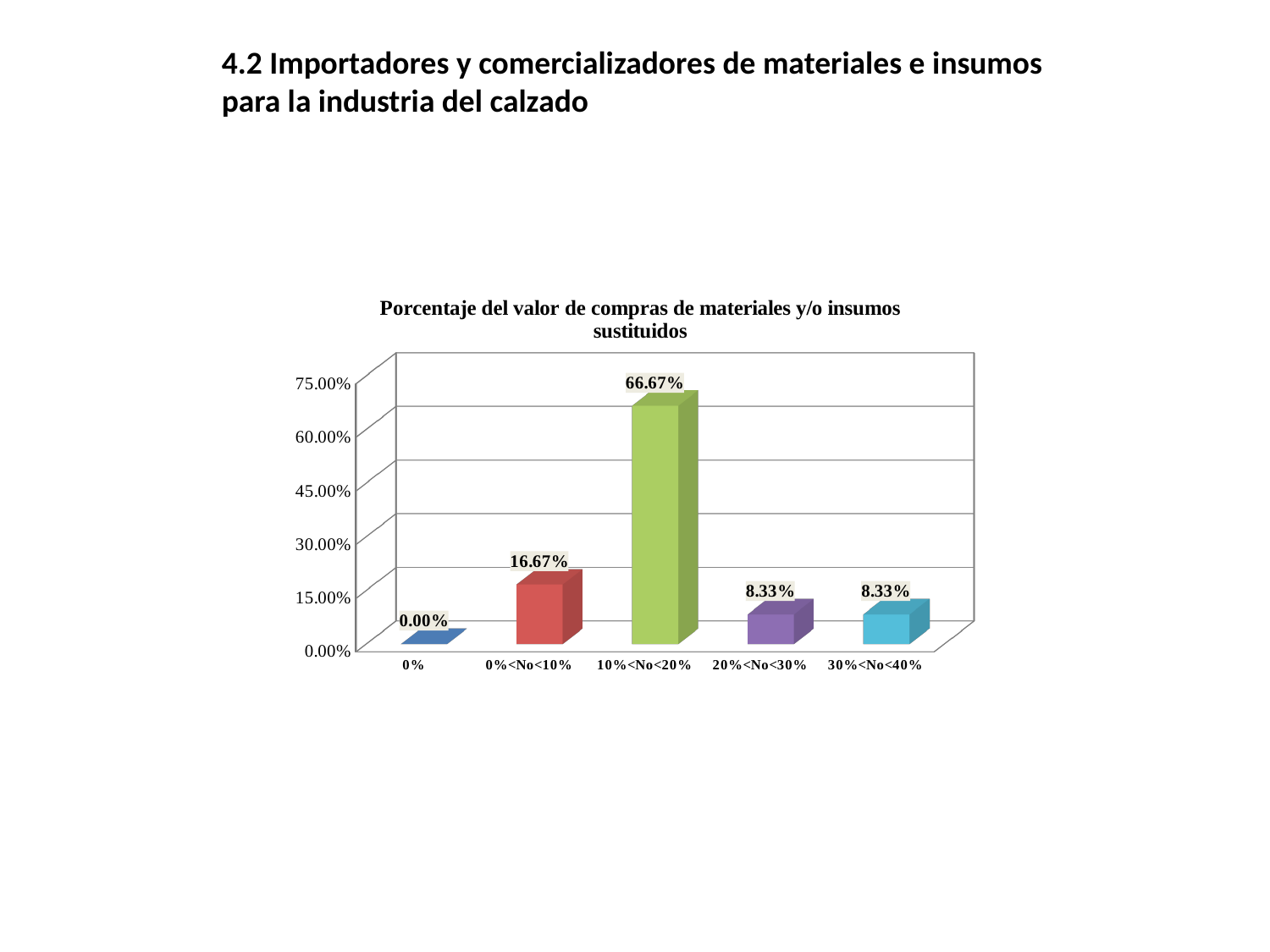
What is the value for the 0% category? 0.00% What is the value for the 0%<No<10% category? 16.67% Which category has the lowest value? 0% Is the value for 10%<No<20% greater or less than 60.00%? greater What is the title of the chart? Porcentaje del valor de compras de materiales y/o insumos sustituidos What is the difference between the values for 10%<No<20% and 0%<No<10%? 50.00% What is the value for the 20%<No<30% category? 8.33% How many categories are shown on the x axis? 5 What kind of chart is shown on the slide? Bar chart What is the value for the 10%<No<20% category? 66.67% Which category has the highest value? 10%<No<20% Which is larger, the value for 0%<No<10% or the value for 30%<No<40%? 0%<No<10%